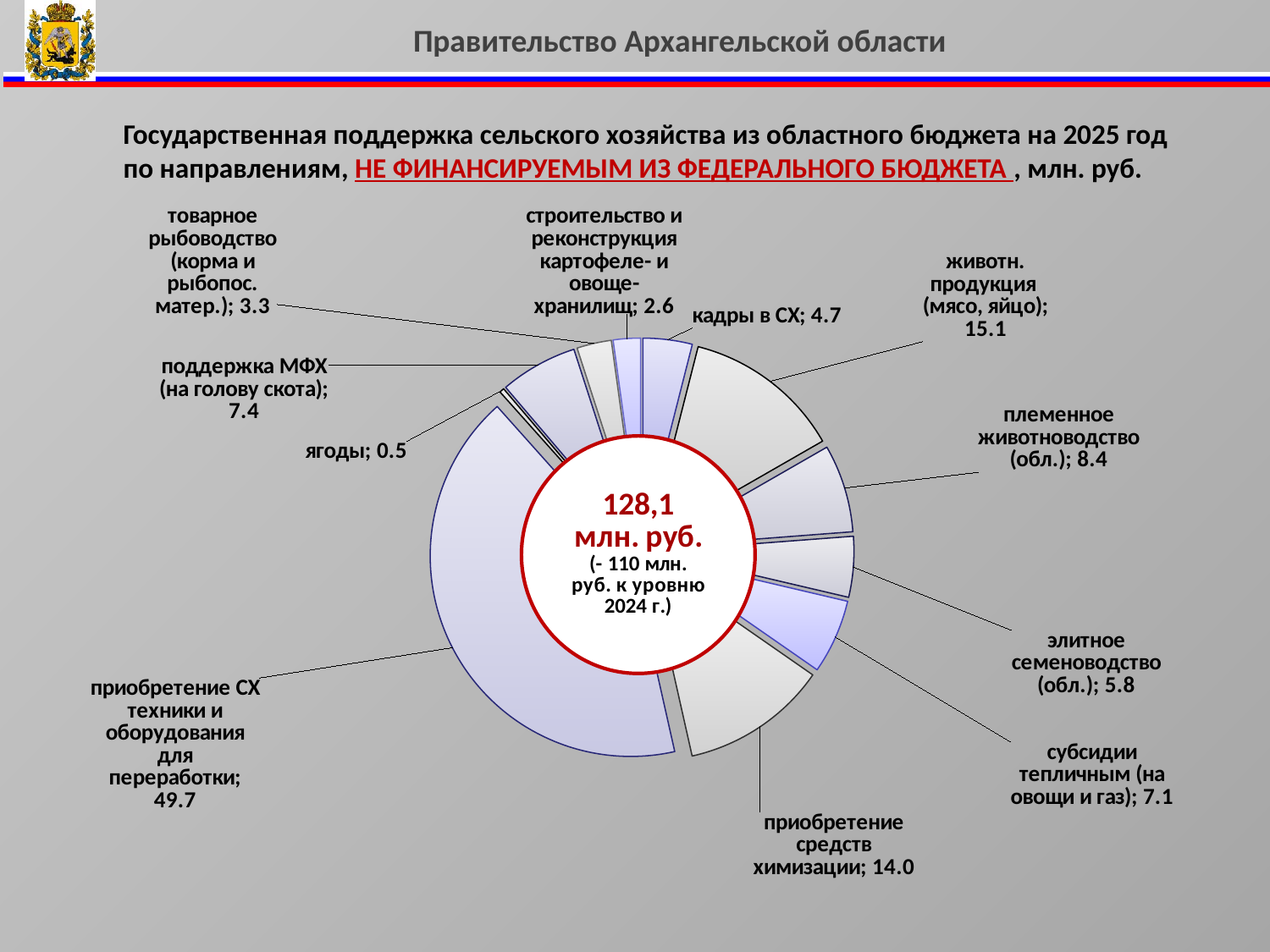
What total amount in млн. руб. is printed in the centre of the chart? 128,1 млн. руб. Which category has the lowest value? ягоды What is the difference between the values for "животн. продукция (мясо, яйцо)" and "приобретение средств химизации"? 1.1 Which category has the highest value? приобретение СХ техники и оборудования для переработки What is the value for "кадры в СХ"? 4.7 How many labeled categories does the chart show? 11 What is the value for "животн. продукция (мясо, яйцо)"? 15.1 What is the value for "субсидии тепличным (на овощи и газ)"? 7.1 Which is larger: the value for "племенное животноводство (обл.)" or for "поддержка МФХ (на голову скота)"? племенное животноводство (обл.) What is the value for "приобретение СХ техники и оборудования для переработки"? 49.7 What is the value for "ягоды"? 0.5 What kind of chart is shown on the slide? doughnut chart